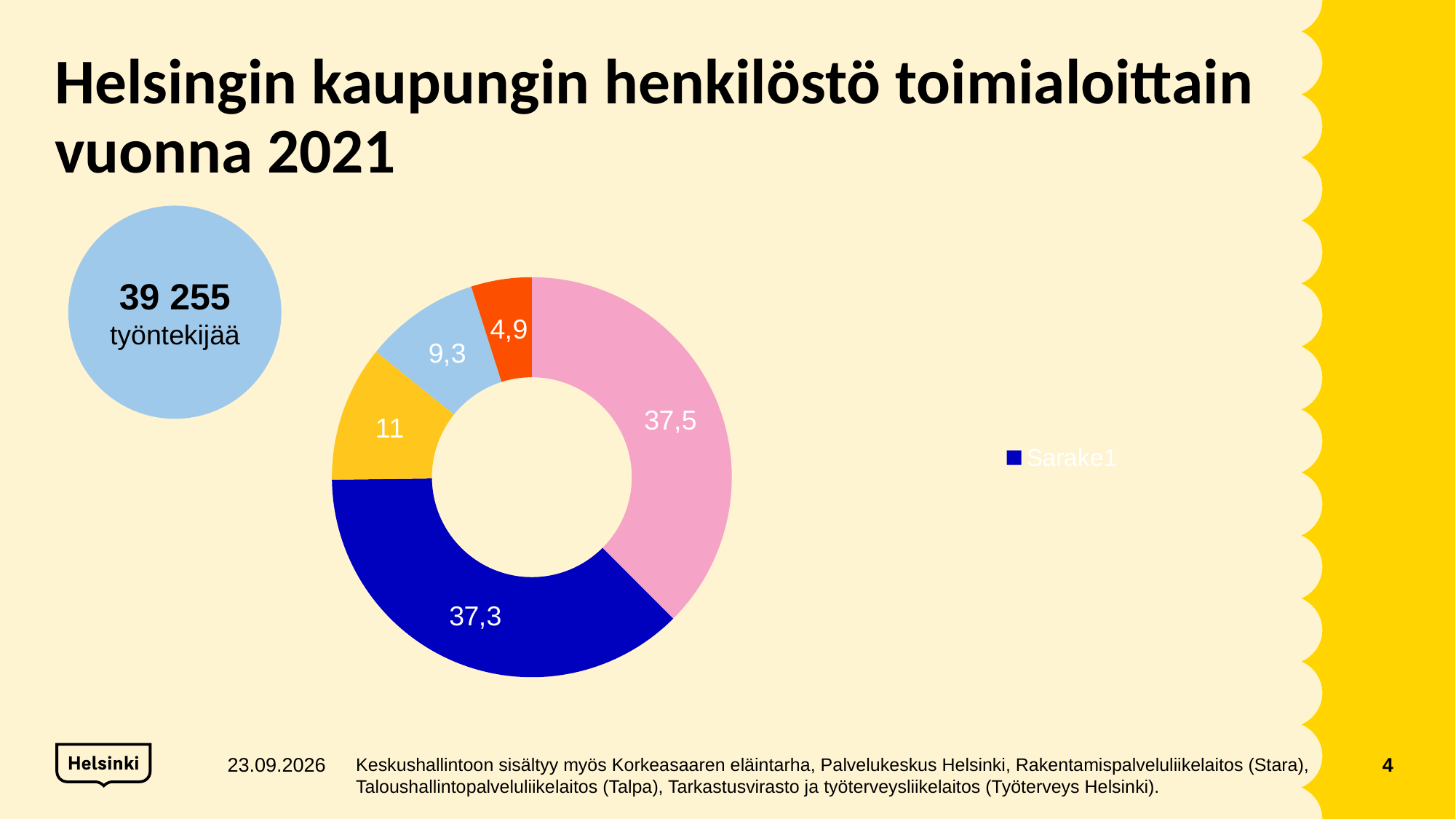
What value is printed on the orange slice of the doughnut chart? 4,9 Which is larger, the value on the yellow slice or the value on the light blue slice? the yellow slice (11) What value is printed on the pink slice of the doughnut chart? 37,5 How many slices does the doughnut chart have? 5 What value is printed on the light blue slice of the doughnut chart? 9,3 What value is printed on the dark blue slice of the doughnut chart? 37,3 Which slice of the doughnut chart has the smallest value? the orange slice (4,9) What value is printed on the yellow slice of the doughnut chart? 11 What type of chart is shown on the slide? doughnut (pie) chart What is the difference between the values on the yellow slice and the light blue slice? 1,7 What is the only entry shown in the chart's legend? Sarake1 What is the difference between the values on the dark blue slice and the yellow slice? 26,3